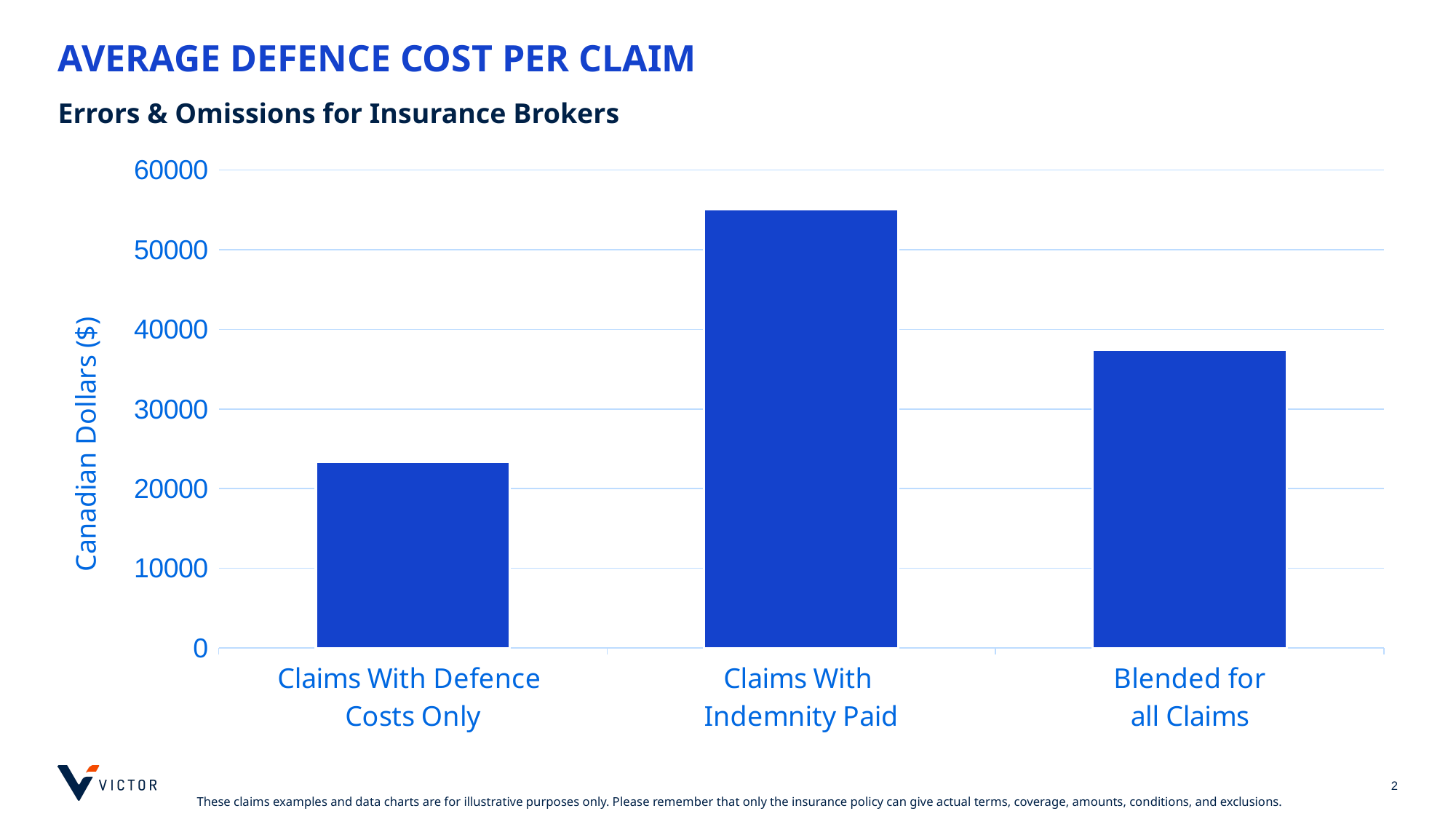
Is the value for Blended for all Claims greater or less than 40000? less Which category has the highest average defence cost per claim? Claims With Indemnity Paid What kind of chart is shown on the slide? bar chart Is the value for Blended for all Claims greater or less than 30000? greater Which is larger: the value for Blended for all Claims or the value for Claims With Defence Costs Only? Blended for all Claims What is the title of the chart on the slide? AVERAGE DEFENCE COST PER CLAIM Which category has the lowest average defence cost per claim? Claims With Defence Costs Only Is the value for Claims With Defence Costs Only greater or less than 30000? less What is the label of the vertical axis? Canadian Dollars ($) How many categories are plotted in the chart? 3 Which is larger: the value for Claims With Indemnity Paid or the value for Blended for all Claims? Claims With Indemnity Paid